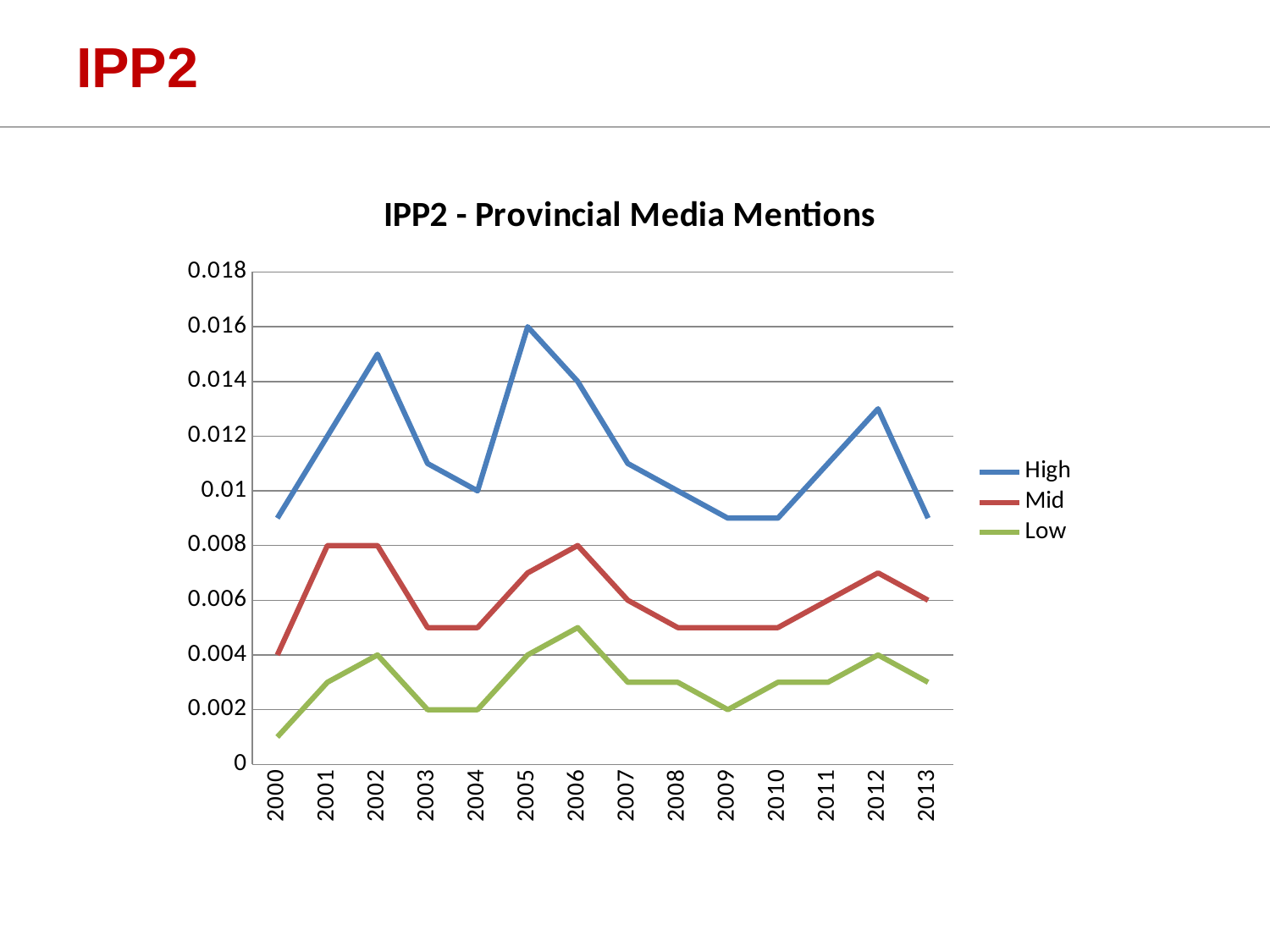
Does the High series rise or fall from 2012 to 2013? fall In which year does the High series reach its highest value? 2005 What is the title of the chart? IPP2 - Provincial Media Mentions Is the value for the High series in 2002 greater or less than 0.014? greater What is the value of the Mid series in 2001? 0.008 How many years are shown on the x axis? 14 What is the value of the Low series in 2009? 0.002 In which year does the Low series have its lowest value? 2000 What is the value of the High series in 2005? 0.016 What kind of chart is shown on the slide? line chart For the Mid series, which year has the larger value, 2006 or 2007? 2006 How many series does the legend list? 3